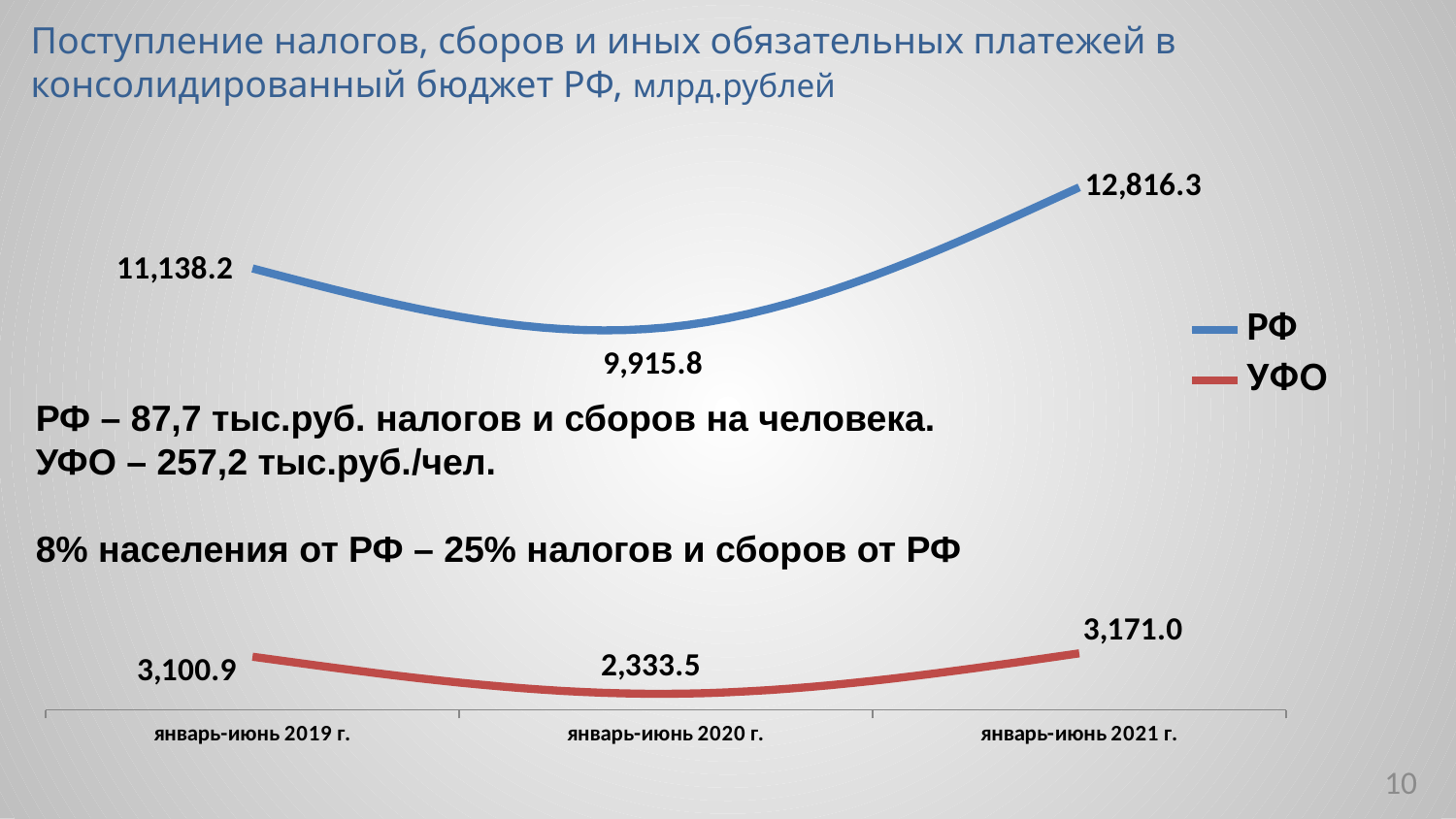
In which period is the РФ value highest? январь-июнь 2021 г. What type of chart is shown on the slide? line chart By how much did the РФ value increase from январь-июнь 2019 г. to январь-июнь 2021 г.? 1,678.1 What is the value for РФ in январь-июнь 2020 г.? 9,915.8 What is the difference between the УФО values for январь-июнь 2019 г. and январь-июнь 2020 г.? 767.4 In which period is the УФО value lowest? январь-июнь 2020 г. What is the value for УФО in январь-июнь 2021 г.? 3,171.0 How many periods are shown on the x axis? 3 Which series has the larger value in январь-июнь 2021 г., РФ or УФО? РФ What is the value for УФО in январь-июнь 2019 г.? 3,100.9 Which series is drawn in red in the legend? УФО How many series does the legend list? 2